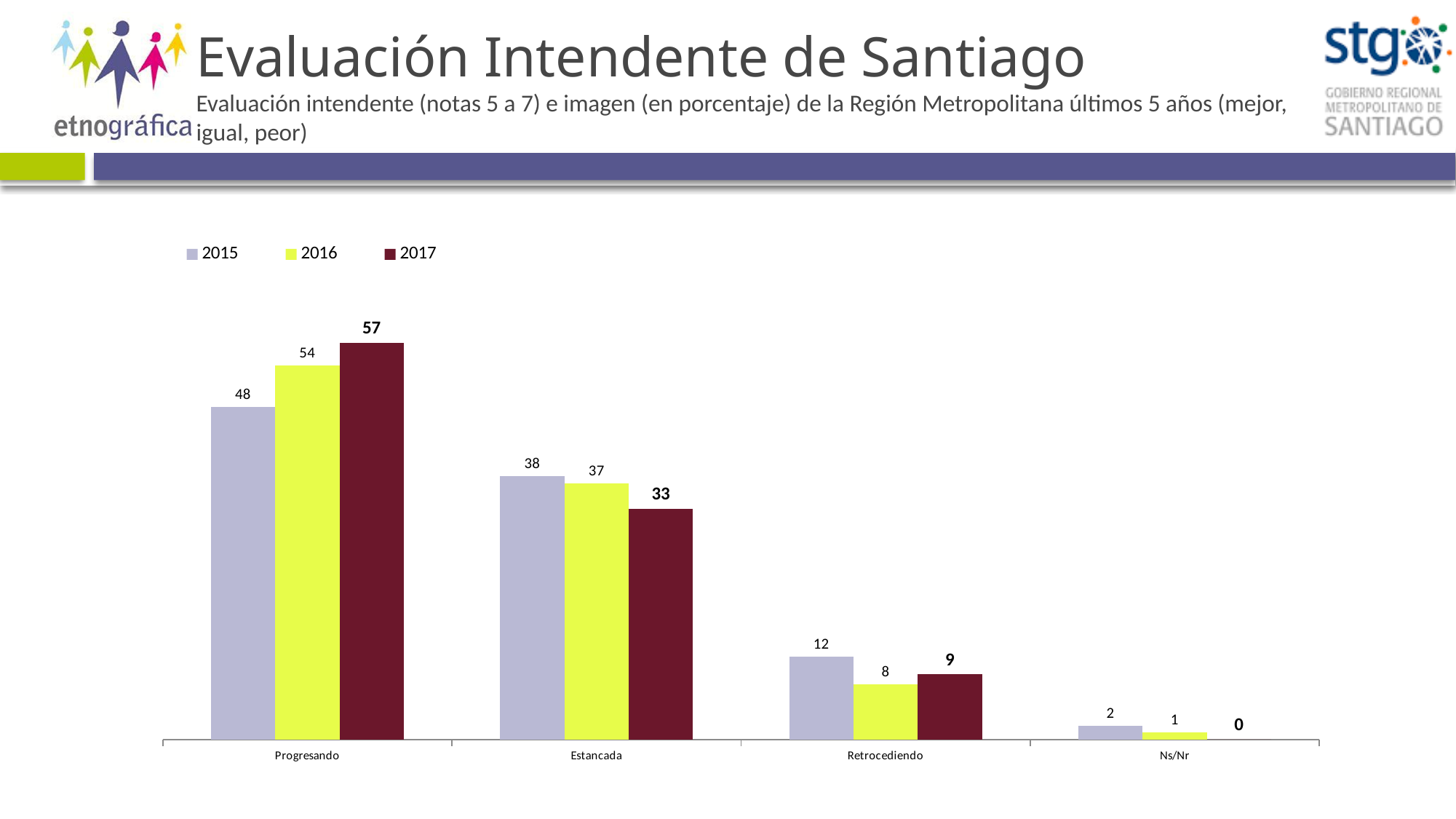
Which series is shown in dark red in the legend? 2017 What is the difference between the 2017 and 2015 values for Progresando? 9 Which category has the highest value for 2016? Progresando What is the value for Retrocediendo in 2016? 8 Which is larger for Estancada: the 2015 value or the 2017 value? 2015 What is the value for Estancada in 2015? 38 Which category has the lowest value for 2015? Ns/Nr What kind of chart is shown on the slide? Bar chart What is the value for Ns/Nr in 2017? 0 How many series does the legend list? 3 What is the value for Progresando in 2017? 57 How many categories are shown on the x axis? 4